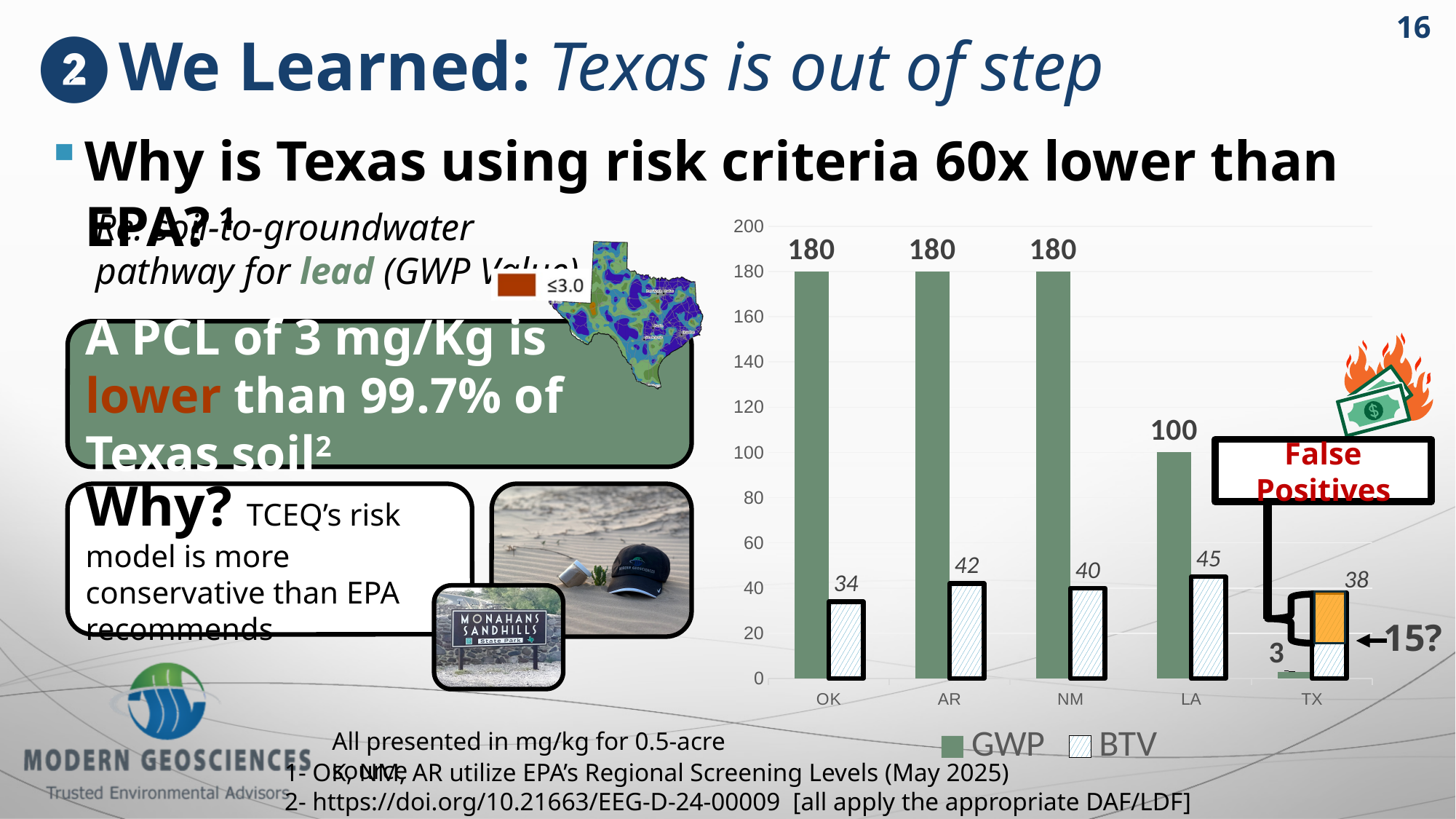
What is the BTV value for OK? 34 What kind of chart is shown on the slide? bar chart Which state has the lowest GWP value? TX How many series does the chart legend list? 2 How many states are shown on the x axis of the chart? 5 What is the GWP value for LA? 100 What are the two series named in the chart legend? GWP and BTV Which state has the highest BTV value? LA What is the difference between the GWP value for OK and the GWP value for LA? 80 Which is larger, the BTV value for NM or the BTV value for TX? NM What is the GWP value for TX? 3 What is the BTV value for AR? 42